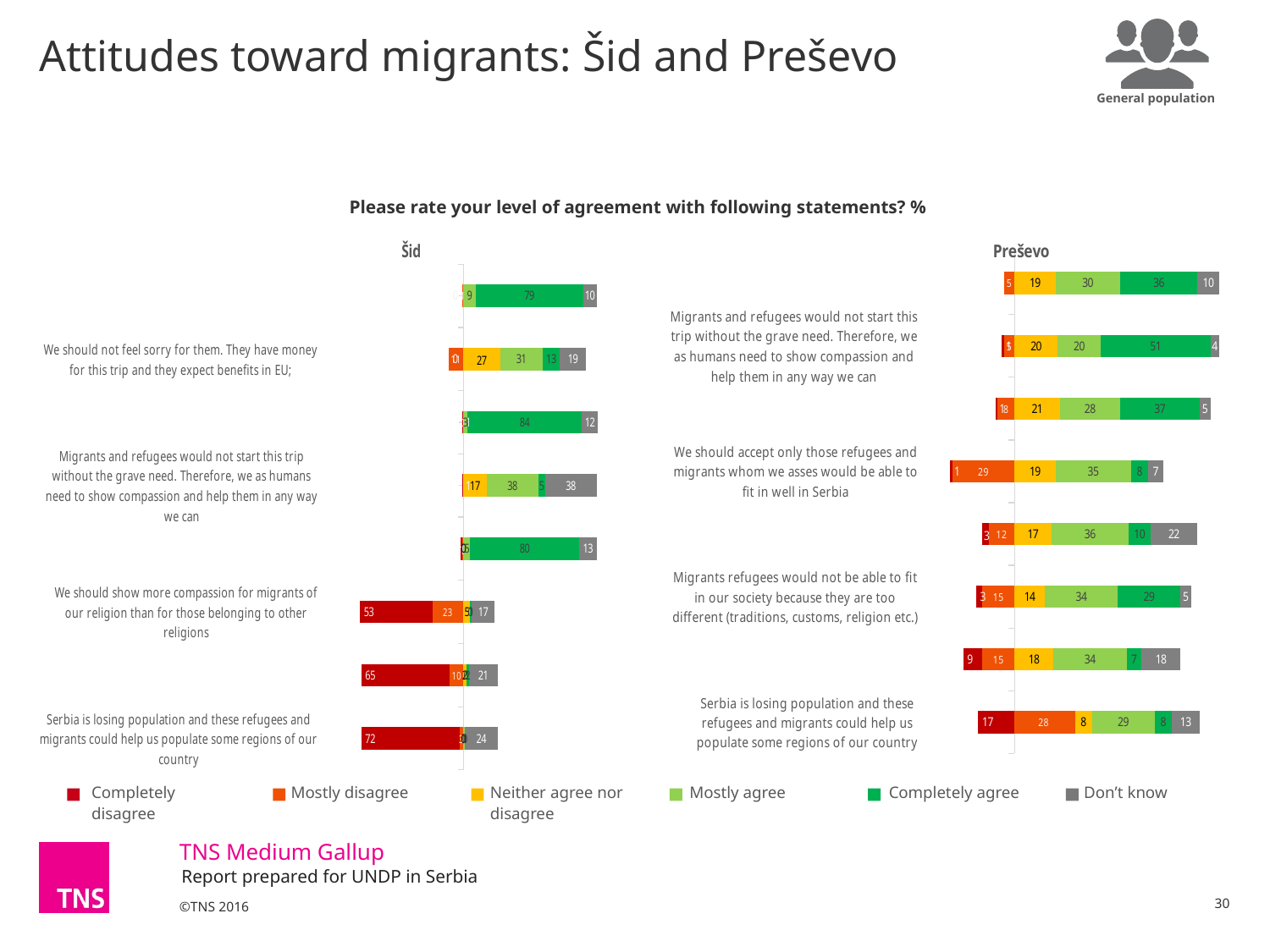
In the Preševo chart, what is the 'Mostly agree' value for the bottom bar? 29 In the Šid chart, what is the 'Completely agree' value for the top bar? 79 What kind of chart is used for the Šid data on this slide? Stacked bar chart In the Preševo chart, what is the 'Completely disagree' value for the bottom bar? 17 In the Preševo chart, what is the 'Mostly agree' value for the top bar? 30 How many series does the legend list? 6 What is the difference between the 'Completely agree' value of the top bar in the Šid chart and the 'Completely agree' value of the top bar in the Preševo chart? 43 How many bars are plotted in the Šid chart? 8 In the Šid chart, what is the 'Completely disagree' value for the bottom bar? 72 Which chart has the larger 'Completely disagree' value for its bottom bar, Šid or Preševo? Šid In the Preševo chart, what is the 'Completely agree' value for the top bar? 36 In the Šid chart, what is the 'Don't know' value for the top bar? 10